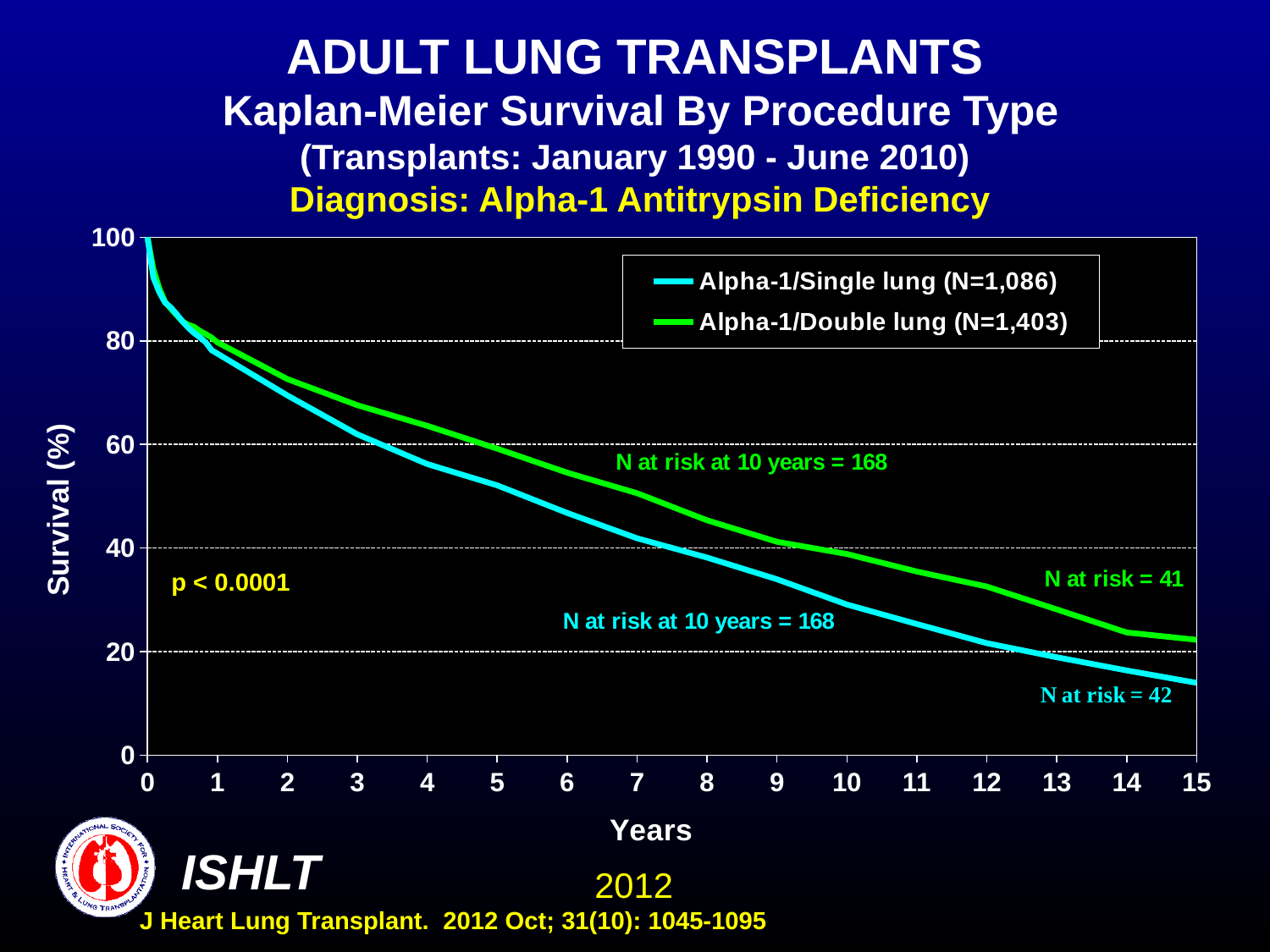
What is the N at risk at the end of follow-up for the Alpha-1/Double lung group? 41 Do the survival curves rise or fall as years increase? fall What is the N for the Alpha-1/Single lung series in the legend? N=1,086 What kind of chart is shown on the slide? line chart What is the N for the Alpha-1/Double lung series in the legend? N=1,403 Is the survival for Alpha-1/Single lung at 5 years greater or less than 60? less What p-value is shown on the chart? p < 0.0001 Is the survival for Alpha-1/Single lung at 15 years greater or less than 20? less Which group has higher survival at 10 years, Alpha-1/Single lung or Alpha-1/Double lung? Alpha-1/Double lung What is the N at risk at the end of follow-up for the Alpha-1/Single lung group? 42 What is the N at risk at 10 years for the Alpha-1/Double lung group? 168 How many series does the legend list? 2